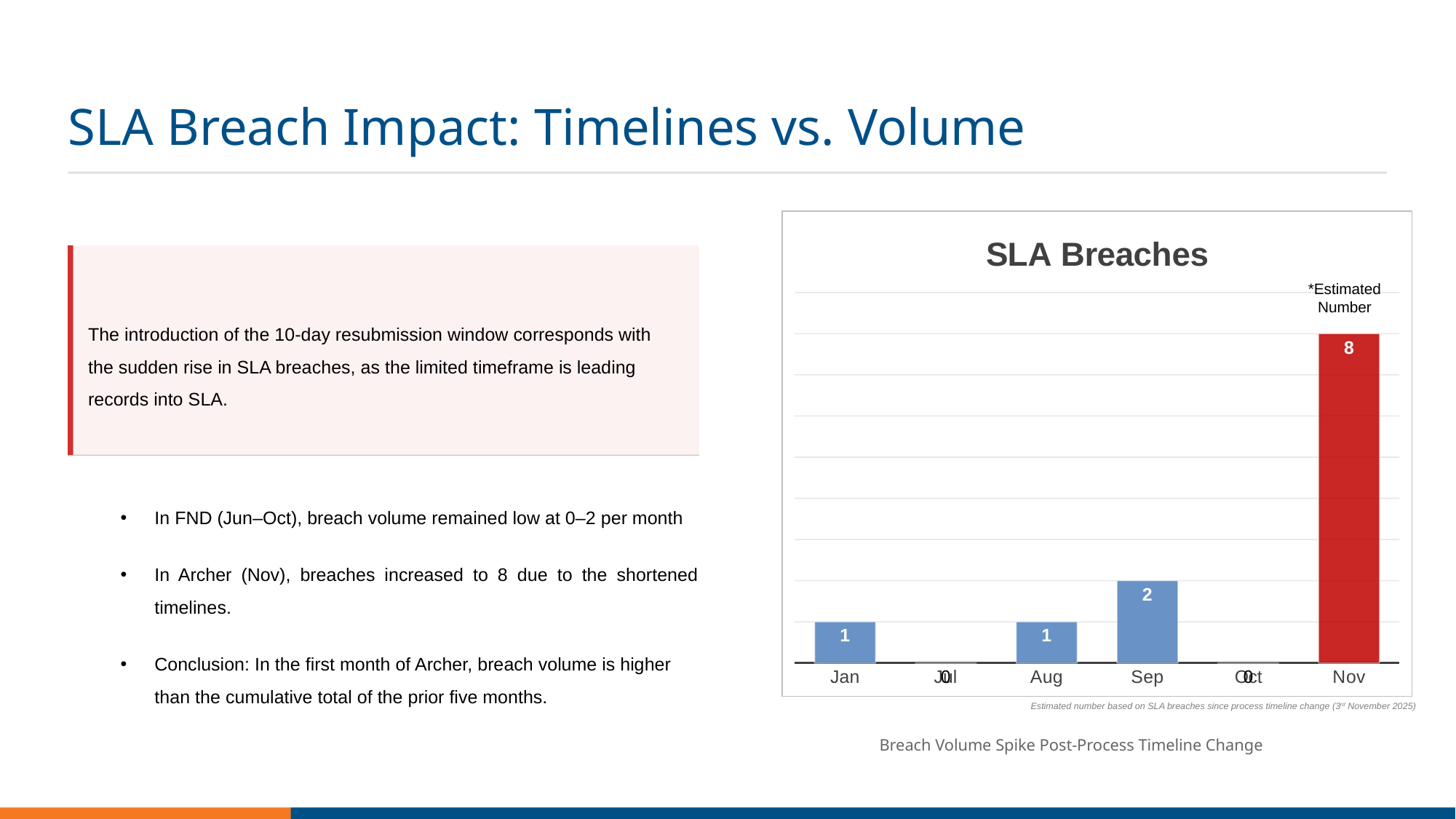
How many months are shown on the x axis of the SLA Breaches chart? 6 What colour is the Nov bar in the SLA Breaches chart? red Which is larger in the SLA Breaches chart, the value for Sep or the value for Jan? Sep What is the difference between the values for Nov and Sep in the SLA Breaches chart? 6 What is the value for Nov in the SLA Breaches chart? 8 Which month has the highest value in the SLA Breaches chart? Nov What is the title of the chart on the slide? SLA Breaches What is the value for Aug in the SLA Breaches chart? 1 What is the value for Sep in the SLA Breaches chart? 2 What is the difference between the values for Sep and Aug in the SLA Breaches chart? 1 What kind of chart is the SLA Breaches chart? bar chart What is the value for Jan in the SLA Breaches chart? 1